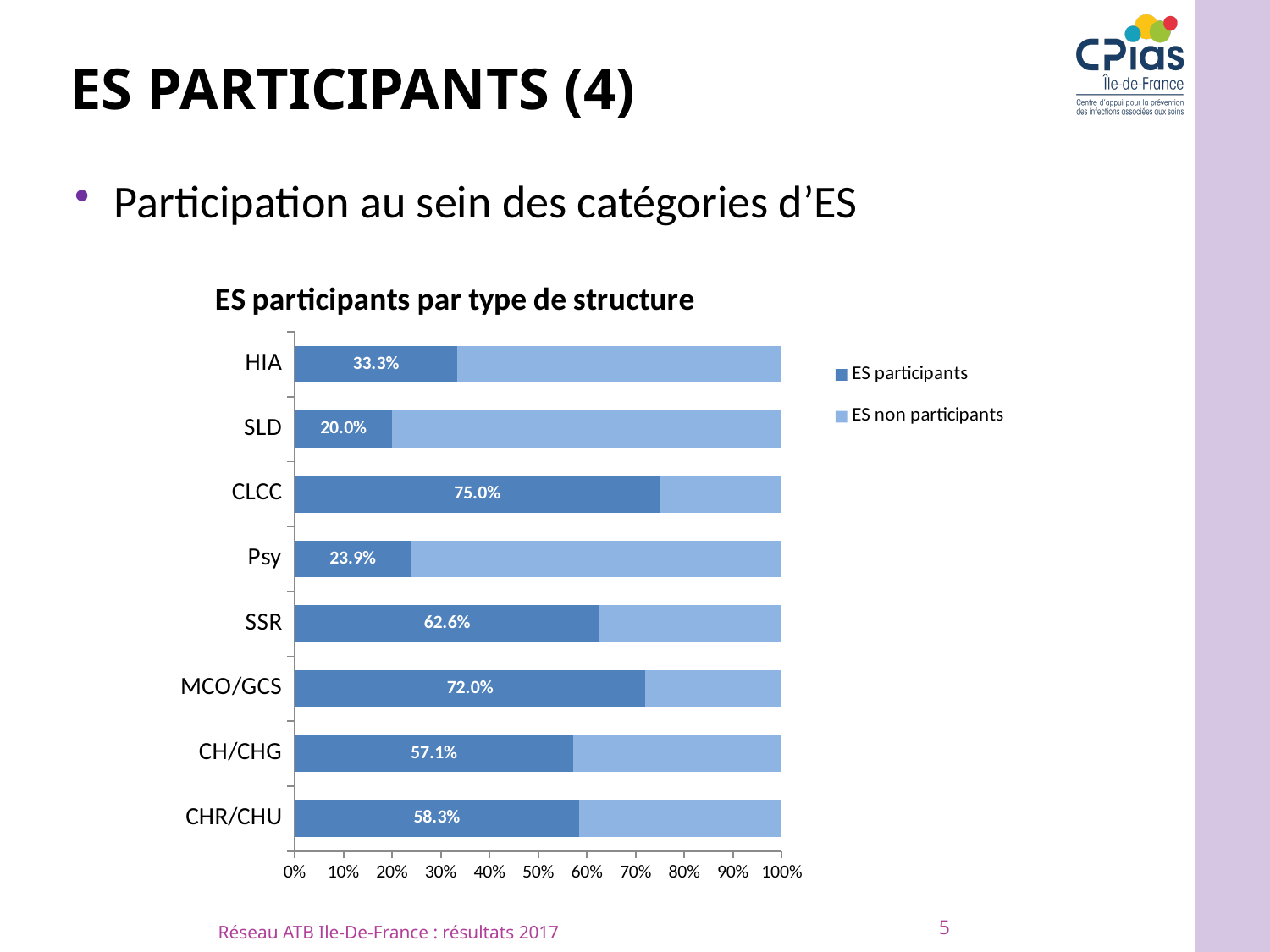
What is the ES participants value for CLCC? 75.0% Which structure type has the lowest ES participants percentage? SLD Which has a higher ES participants percentage, HIA or Psy? HIA How many structure types are shown on the chart? 8 Is the ES non participants value for Psy greater or less than 70%? greater How many series does the legend list? 2 What is the difference in ES participants percentage between MCO/GCS and SSR? 9.4% What is the ES participants value for CHR/CHU? 58.3% What is the ES participants value for SLD? 20.0% Which structure type has the highest ES participants percentage? CLCC What kind of chart is shown? Stacked bar chart What is the title of the chart? ES participants par type de structure